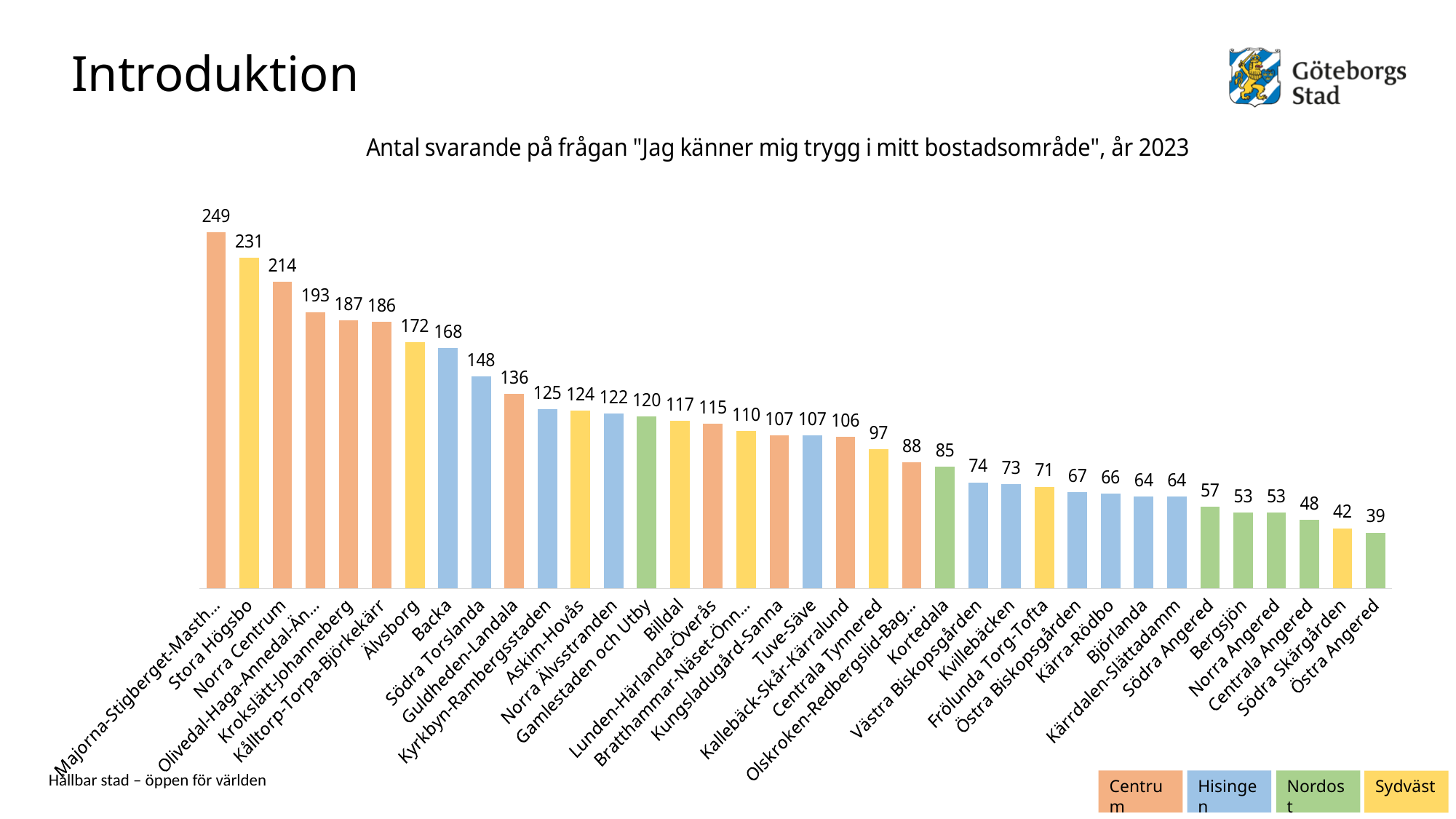
How many respondents are shown for Backa? 168 How many series does the legend list? 4 Which legend entry is shown in green? Nordost Do the values rise or fall from left to right along the x axis? fall Which has more respondents, Älvsborg or Södra Torslanda? Älvsborg Which area has the highest number of respondents? Majorna-Stigberget-Masth... What is the value for Frölunda Torg-Tofta? 71 What is the value for Kortedala? 85 Which has a higher value, Bergsjön or Centrala Angered? Bergsjön What type of chart is shown on the slide? bar chart Which area has the lowest number of respondents? Östra Angered What is the difference between the values for Stora Högsbo and Norra Centrum? 17